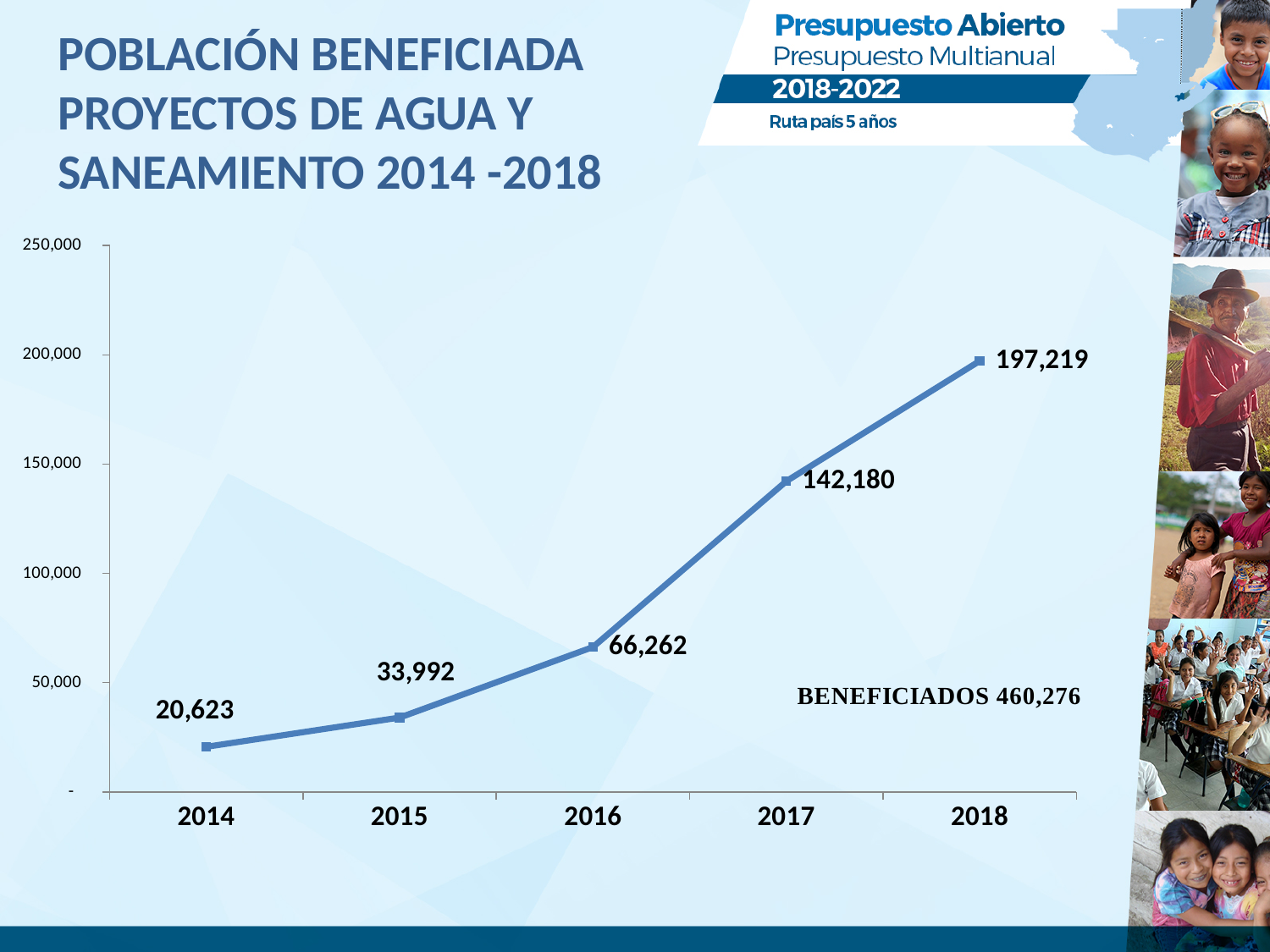
Which year has the highest value? 2018 What kind of chart is shown on the slide? line chart What is the difference between the values for 2016 and 2015? 32,270 What is the value for 2016? 66,262 What is the difference between the values for 2018 and 2017? 55,039 What is the value for 2014? 20,623 What is the value for 2018? 197,219 Which is larger, the value for 2017 or the value for 2016? 2017 Do the values rise or fall from 2014 to 2018? rise How many years are plotted on the chart? 5 Is the value for 2017 greater or less than 100,000? greater Which year has the lowest value? 2014